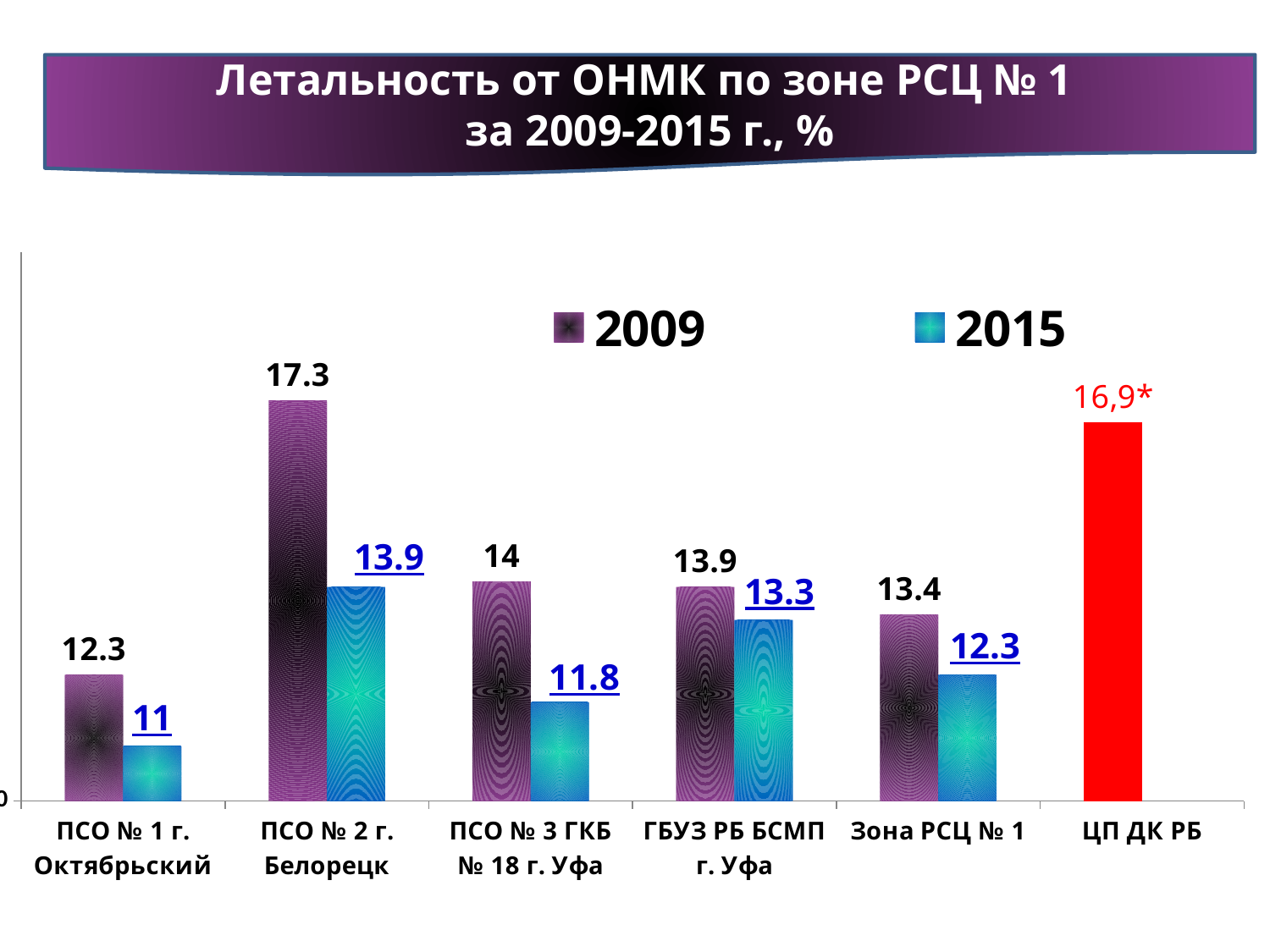
What is the 2009 value for ПСО № 2 г. Белорецк? 17.3 How many series does the legend list? 2 Which category has the lowest 2015 value? ПСО № 1 г. Октябрьский What value is labelled on the red bar for ЦП ДК РБ? 16,9* What is the difference between the 2009 and 2015 values for ПСО № 2 г. Белорецк? 3.4 What is the 2015 value for Зона РСЦ № 1? 12.3 Which category has the highest 2009 value? ПСО № 2 г. Белорецк Which is larger for ГБУЗ РБ БСМП г. Уфа: the 2009 value or the 2015 value? 2009 What kind of chart is shown on the slide? Bar chart What is the 2015 value for ПСО № 3 ГКБ № 18 г. Уфа? 11.8 What is the title of the chart? Летальность от ОНМК по зоне РСЦ № 1 за 2009-2015 г., % How many categories are shown on the x axis? 6